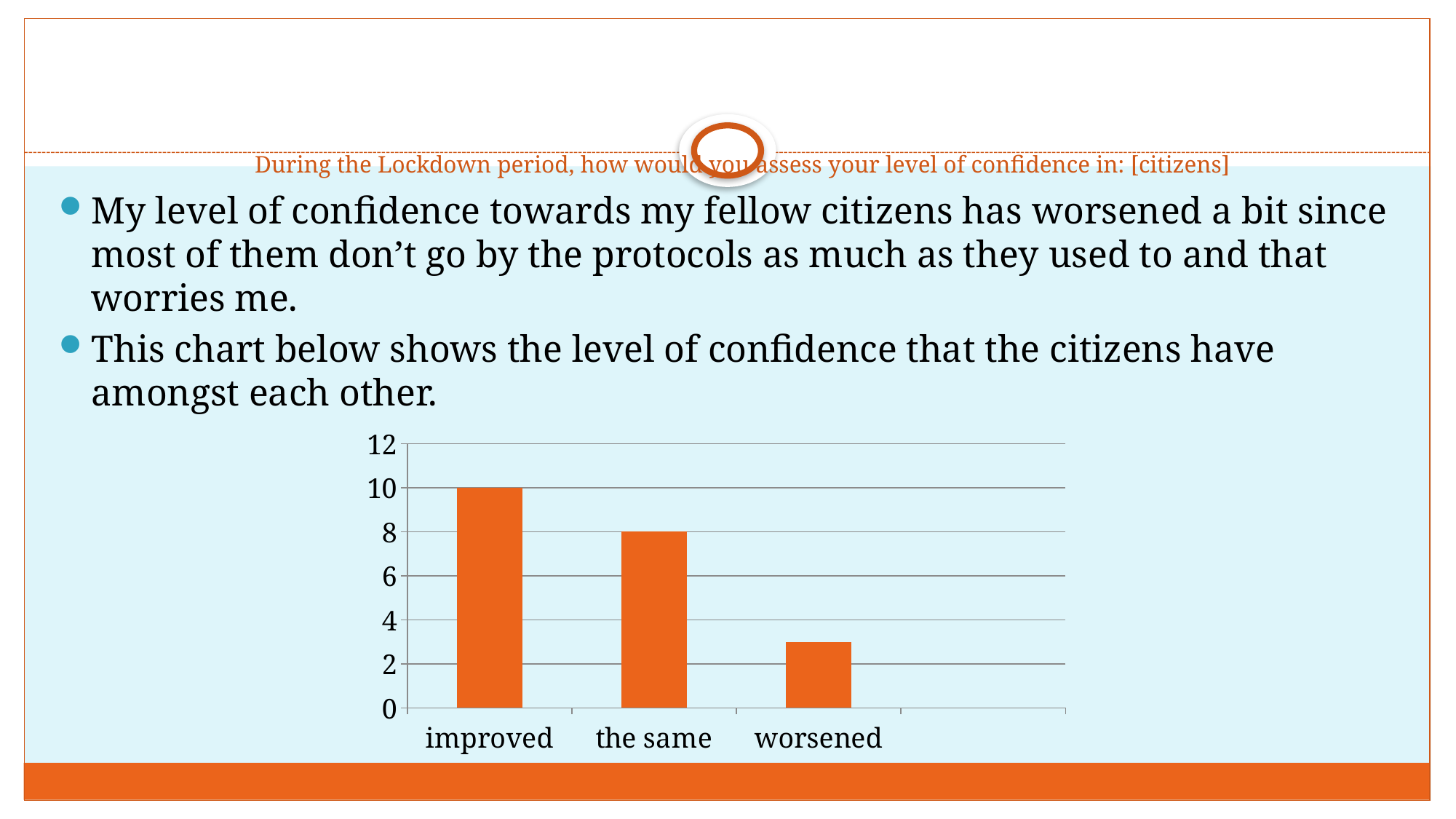
Which category has the lowest value? worsened Which category has the highest value? improved Do the values rise or fall from left to right along the x axis? fall Which is larger, the value for "improved" or the value for "the same"? improved What colour are the bars in the chart? orange What is the difference between the values for "improved" and "the same"? 2 Is the value for "worsened" greater or less than 4? less What kind of chart is shown on the slide? bar chart What is the value for "improved"? 10 Is the value for "worsened" greater or less than 2? greater How many categories are shown on the x axis of the chart? 3 What is the value for "the same"? 8